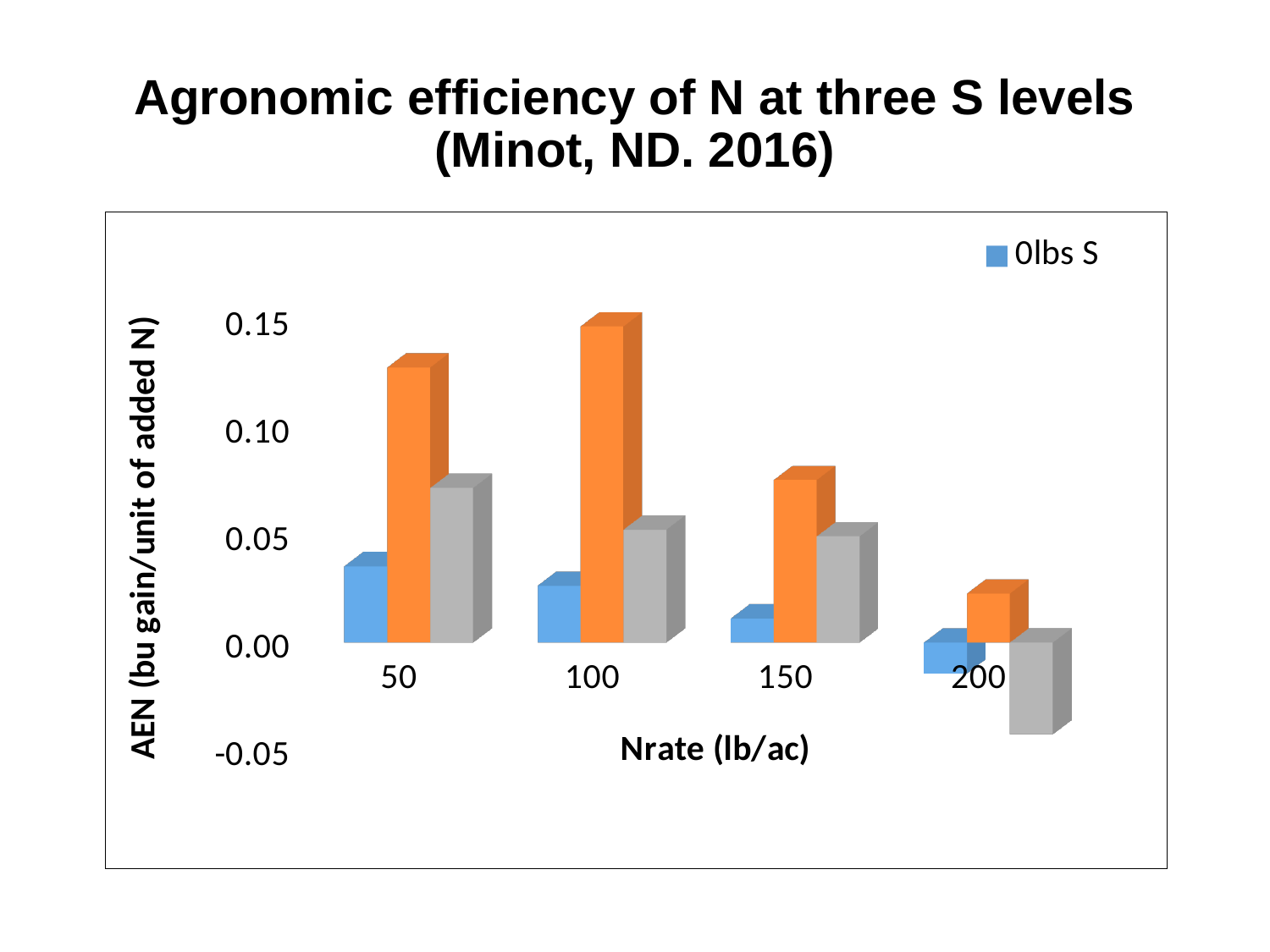
Is the value of the orange bar at Nrate 100 greater or less than 0.10? greater What is the y-axis title of the chart? AEN (bu gain/unit of added N) At which Nrate is the blue (0lbs S) bar lowest? 200 What is the label of the only legend entry? 0lbs S How many N rate categories are shown on the x axis? 4 Do the blue (0lbs S) bars rise or fall as Nrate increases from 50 to 200? fall How many series does the legend list? 1 Is the value of the blue (0lbs S) bar at Nrate 50 greater or less than 0.05? less Is the value of the gray bar at Nrate 200 greater or less than 0.00? less What kind of chart is shown on the slide? bar chart At which Nrate is the orange bar highest? 100